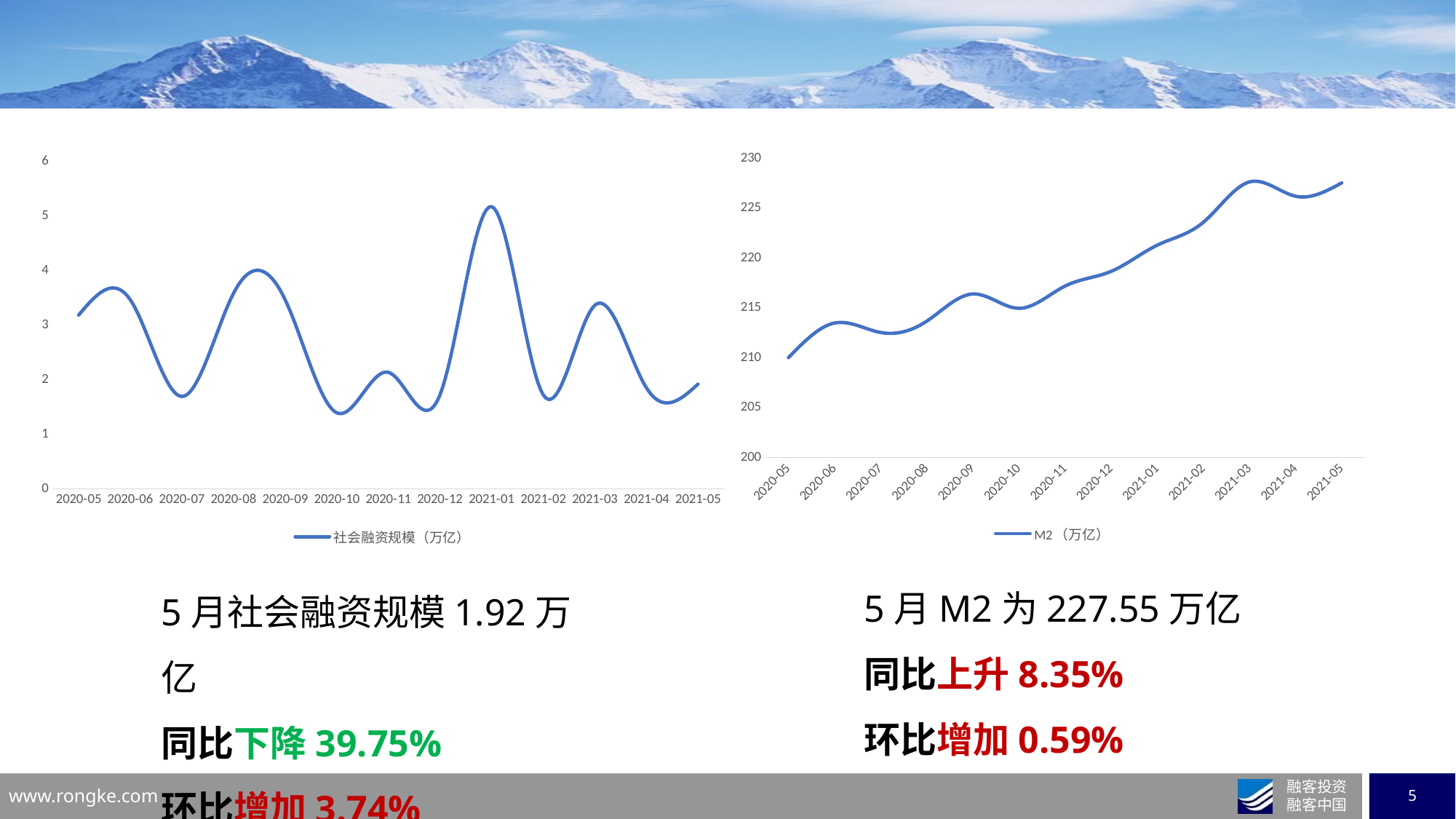
According to the slide, what is the 社会融资规模 value for 2021-05 in the left chart? 1.92 万亿 In the left chart (社会融资规模), which is larger, the value for 2020-08 or the value for 2020-10? 2020-08 What kind of chart is the left chart (社会融资规模)? line chart In the right chart (M2), which month has the lowest value? 2020-05 In the left chart (社会融资规模), is the value for 2021-01 greater or less than 4? greater In the right chart (M2), how many series does the legend list? 1 In the left chart (社会融资规模), how many months are plotted along the x axis? 13 In the left chart (社会融资规模), which month has the highest value? 2021-01 In the right chart (M2), is the value for 2020-05 greater or less than 215? less What is the legend entry of the right chart? M2（万亿） What kind of chart is the right chart (M2)? line chart In the right chart (M2), do the values generally rise or fall from 2020-05 to 2021-05? rise